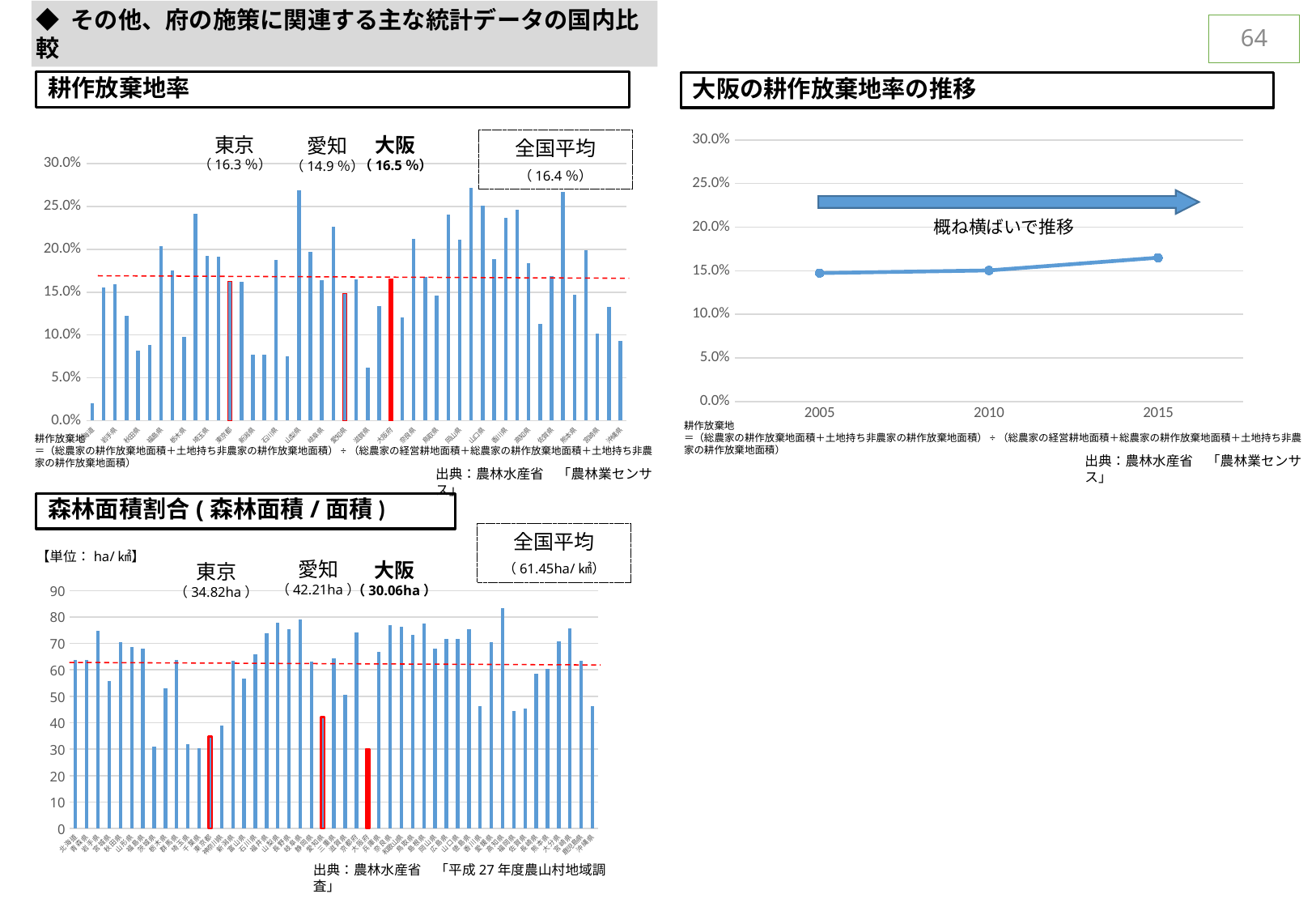
In the 耕作放棄地率 chart, what is the value shown for 大阪? 16.5% What kind of chart is 大阪の耕作放棄地率の推移? Line chart How many data points are plotted in the 大阪の耕作放棄地率の推移 chart? 3 In the 耕作放棄地率 chart, what is the difference between the values for 大阪 (16.5%) and 愛知 (14.9%)? 1.6 percentage points In the 耕作放棄地率 chart, what is the value shown for 東京? 16.3% In the 耕作放棄地率 chart, which has the higher value, 大阪 or 愛知? 大阪 In the 森林面積割合 chart, what is the 全国平均 (national average) value shown? 61.45ha/㎢ In the 森林面積割合 chart, what is the value shown for 大阪? 30.06ha In the 森林面積割合 chart, what is the difference between the values for 愛知 (42.21ha) and 東京 (34.82ha)? 7.39ha In the 大阪の耕作放棄地率の推移 chart, is the value for 2005 greater or less than 20.0%? less In the 耕作放棄地率 chart, what is the 全国平均 (national average) value shown? 16.4% In the 大阪の耕作放棄地率の推移 chart, how do the values change from 2005 to 2015? Roughly flat, slightly rising